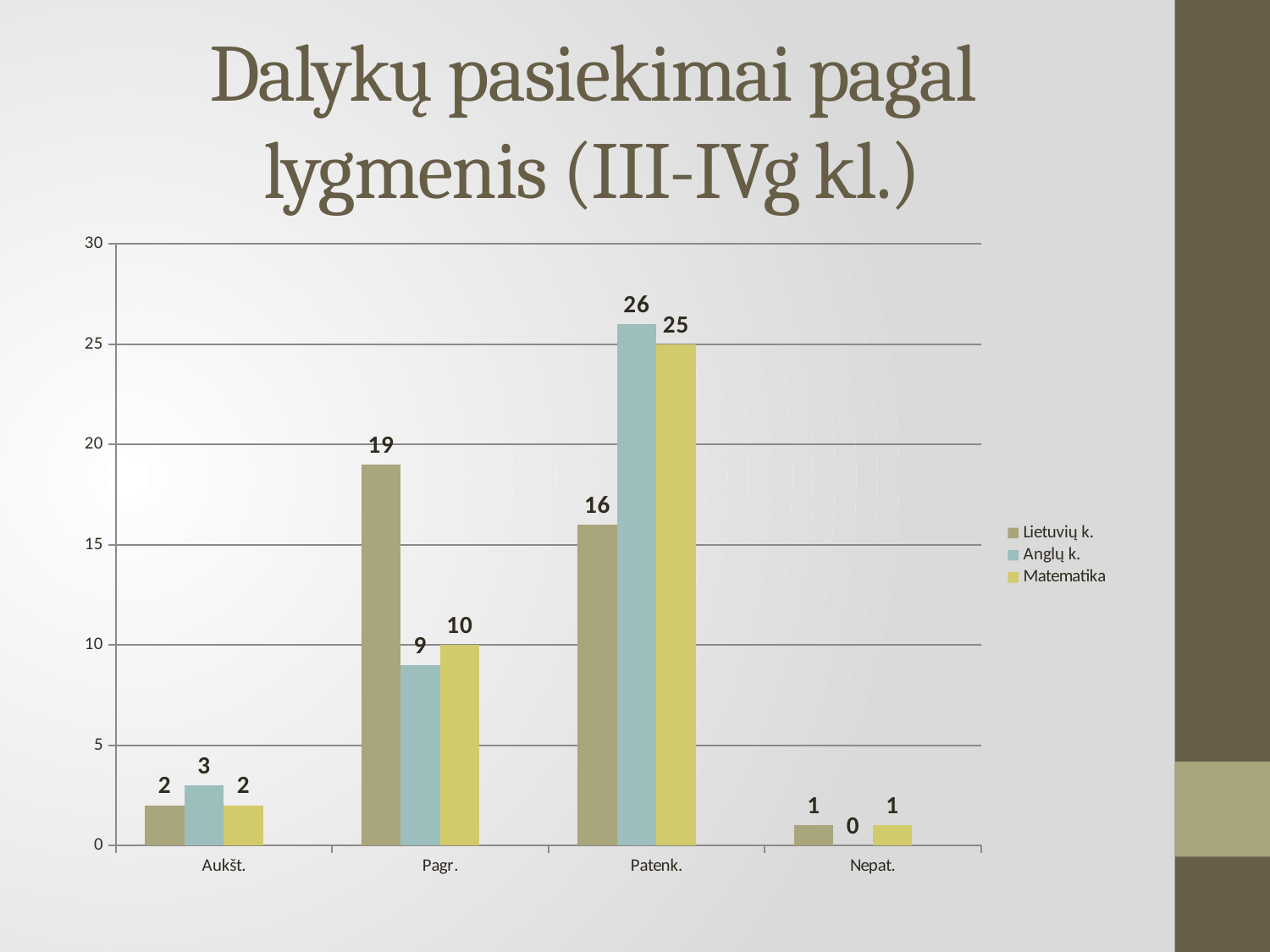
What is the value for Anglų k. in the Patenk. category? 26 Which category has the highest value for Matematika? Patenk. What is the difference between Lietuvių k. and Anglų k. in the Pagr. category? 10 How many series does the legend list? 3 What is the title of the chart on the slide? Dalykų pasiekimai pagal lygmenis (III-IVg kl.) How many categories are shown on the x axis? 4 What is the value for Lietuvių k. in the Pagr. category? 19 What is the value for Matematika in the Nepat. category? 1 In the Patenk. category, which is larger: Lietuvių k. or Matematika? Matematika Is the value for Anglų k. in the Patenk. category greater or less than 25? greater What kind of chart is shown on the slide? Bar chart Which category has the lowest value for Anglų k.? Nepat.